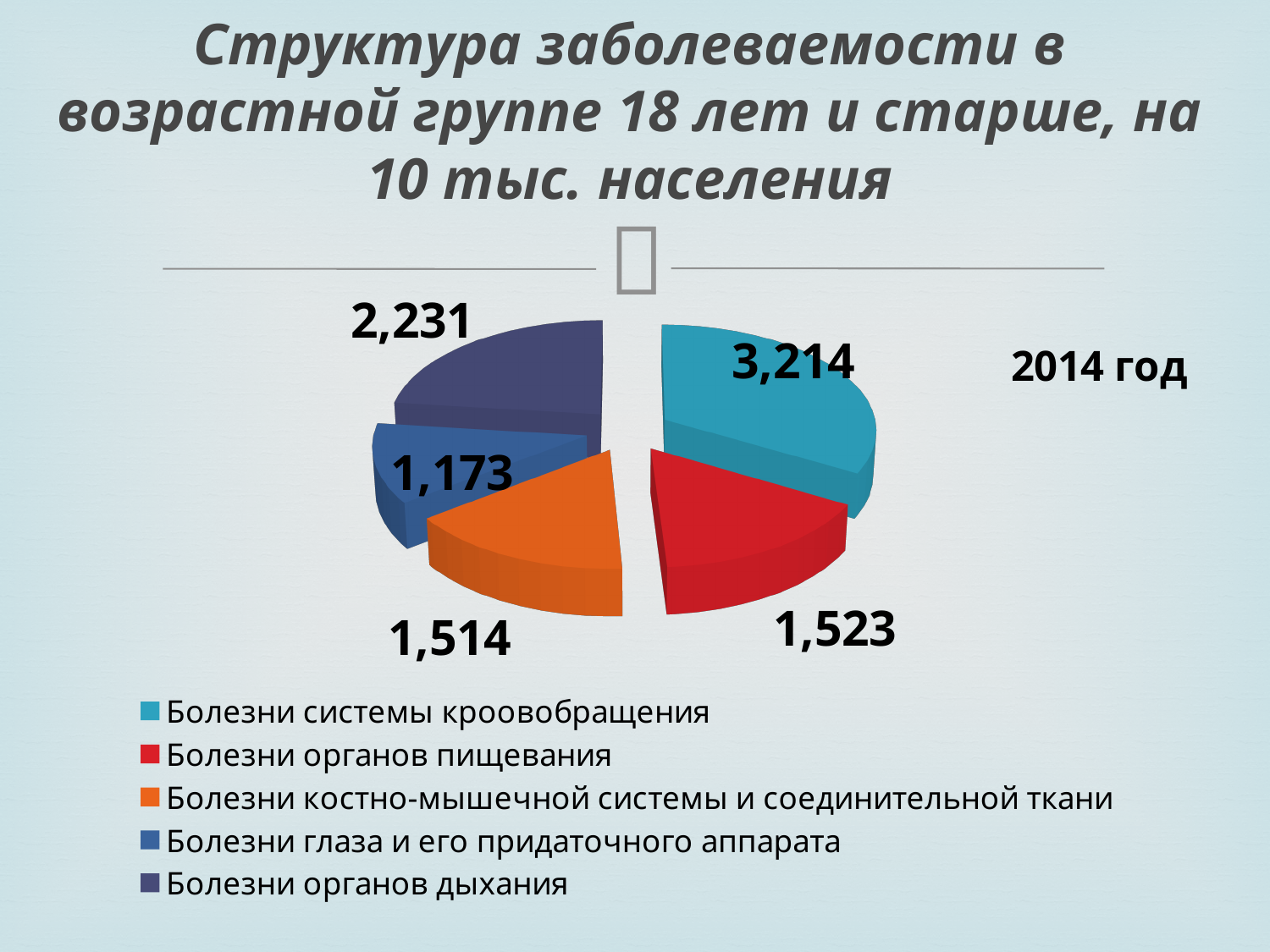
Which year is the chart labelled with? 2014 год What is the value for Болезни органов дыхания? 2,231 Which is larger: the value for Болезни органов дыхания or the value for Болезни органов пищевания? Болезни органов дыхания Which category has the lowest value? Болезни глаза и его придаточного аппарата What kind of chart is shown on the slide? Pie chart Which category has the highest value? Болезни системы кроовобращения What is the value for Болезни системы кроовобращения? 3,214 What is the difference between the values for Болезни органов пищевания and Болезни костно-мышечной системы и соединительной ткани? 9 What is the difference between the values for Болезни системы кроовобращения and Болезни органов дыхания? 983 What is the value for Болезни костно-мышечной системы и соединительной ткани? 1,514 What is the value for Болезни глаза и его придаточного аппарата? 1,173 How many categories does the pie chart show? 5